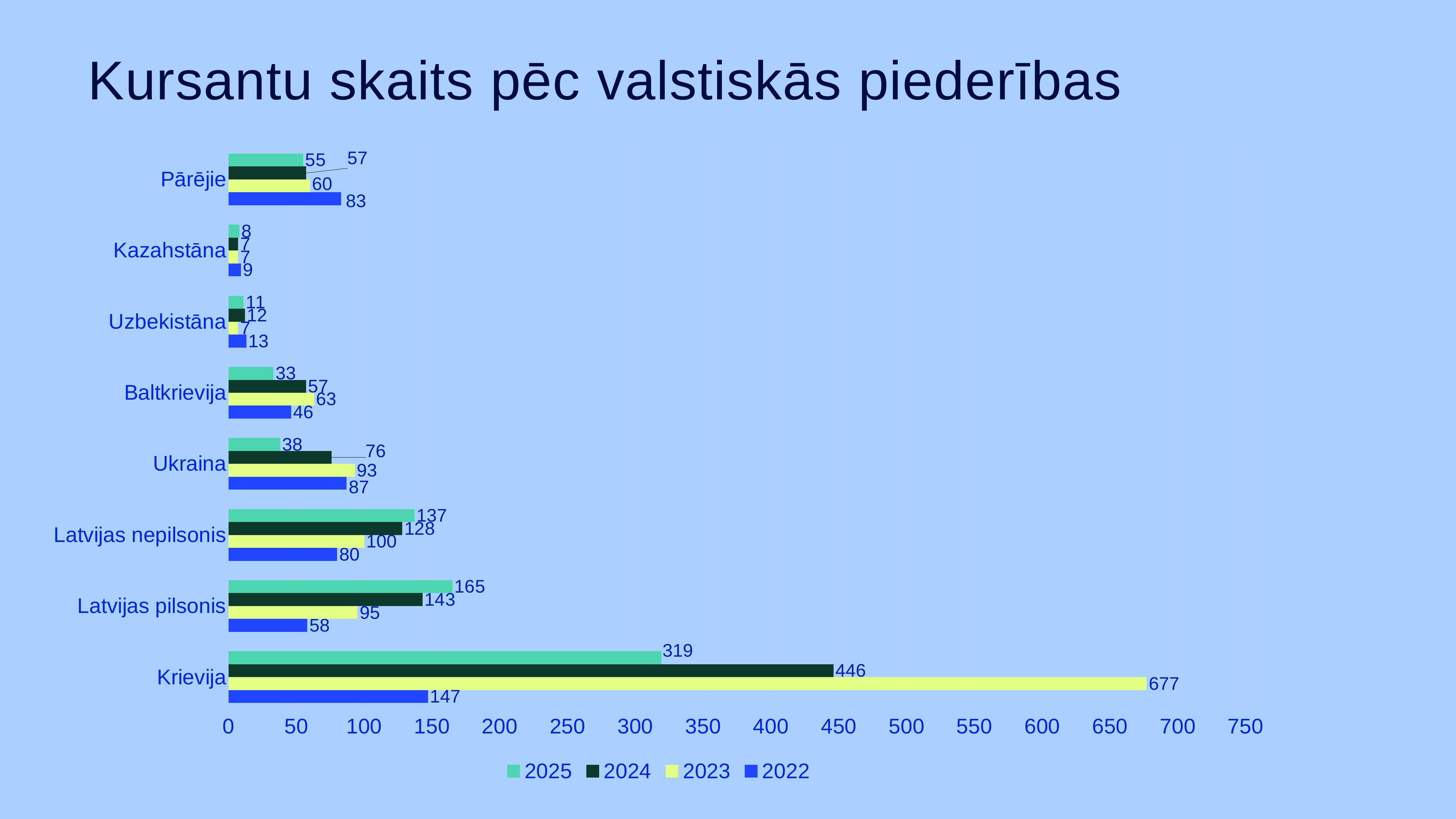
Which category has the highest value in the 2024 series? Krievija What is the title of the chart? Kursantu skaits pēc valstiskās piederības What is the value for Ukraina in 2022? 87 What is the difference between the 2024 and 2025 values for Krievija? 127 Which is larger for Baltkrievija: the 2023 value or the 2022 value? 2023 What is the value for Latvijas pilsonis in 2025? 165 What is the value for Krievija in 2023? 677 Which category has the lowest value in the 2022 series? Kazahstāna How many series does the legend list? 4 How many categories are shown on the chart? 8 What type of chart is shown on the slide? bar chart What is the difference between the 2025 and 2022 values for Latvijas nepilsonis? 57